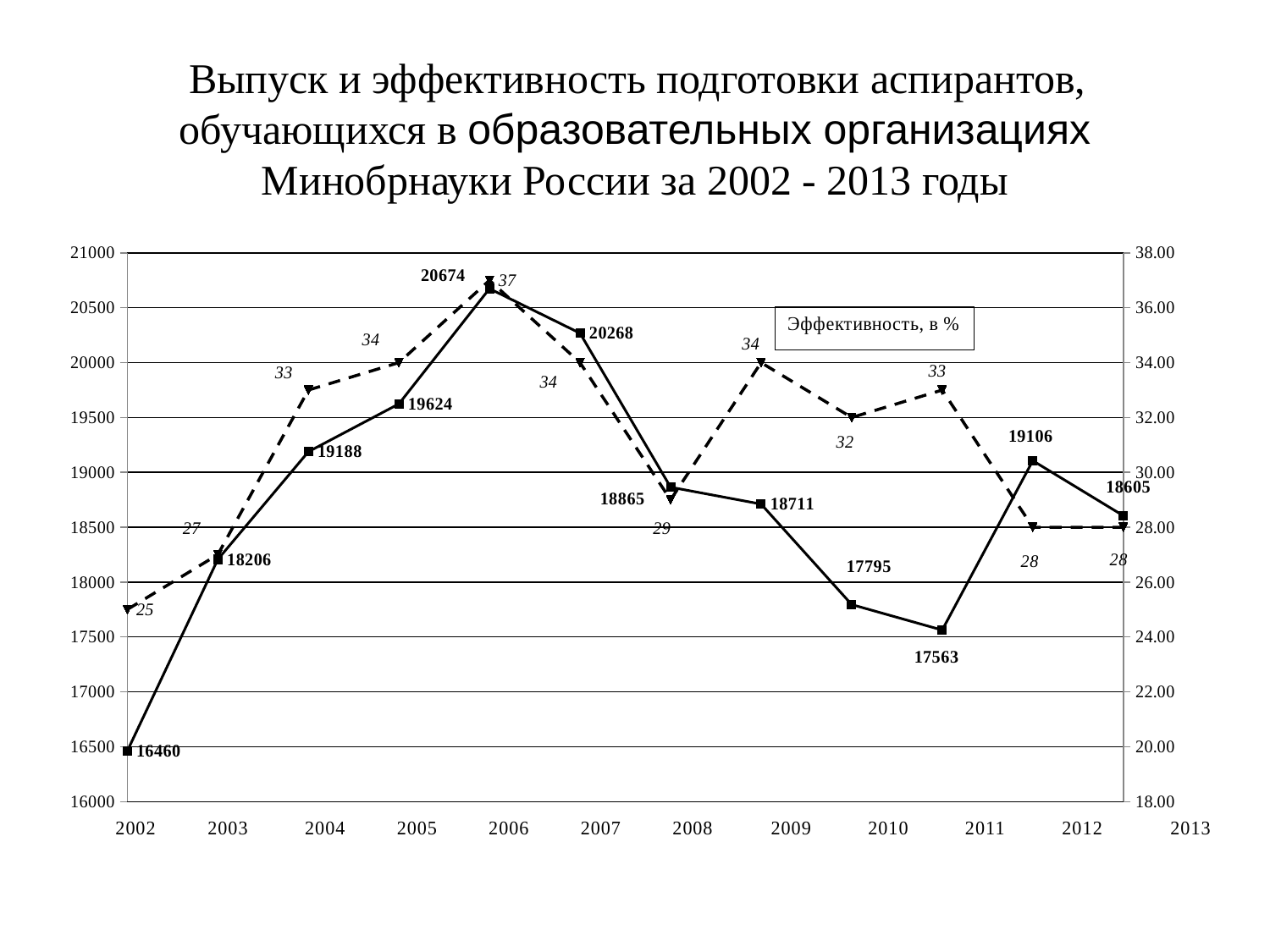
Which is larger, the number of graduates in 2012 (19106) or in 2013 (18605)? 2012 (19106) What kind of chart is shown on the slide? line chart How many data points does the solid graduates line have? 12 What is the number of graduates shown for 2003? 18206 What is the lowest value on the solid line (number of graduates)? 16460 What is the highest value on the solid line (number of graduates), and in which year does it occur? 20674 in 2006 What is the difference between the highest graduate value (20674) and the lowest graduate value (16460)? 4214 Does the solid graduates line rise or fall from 2002 to 2006? rise What is the lowest efficiency value (dashed line) shown on the chart? 25 What is the number of graduates shown for 2010? 17795 What is the highest efficiency value (dashed line) shown on the chart? 37 What label is given to the dashed line in the text box on the chart? Эффективность, в %